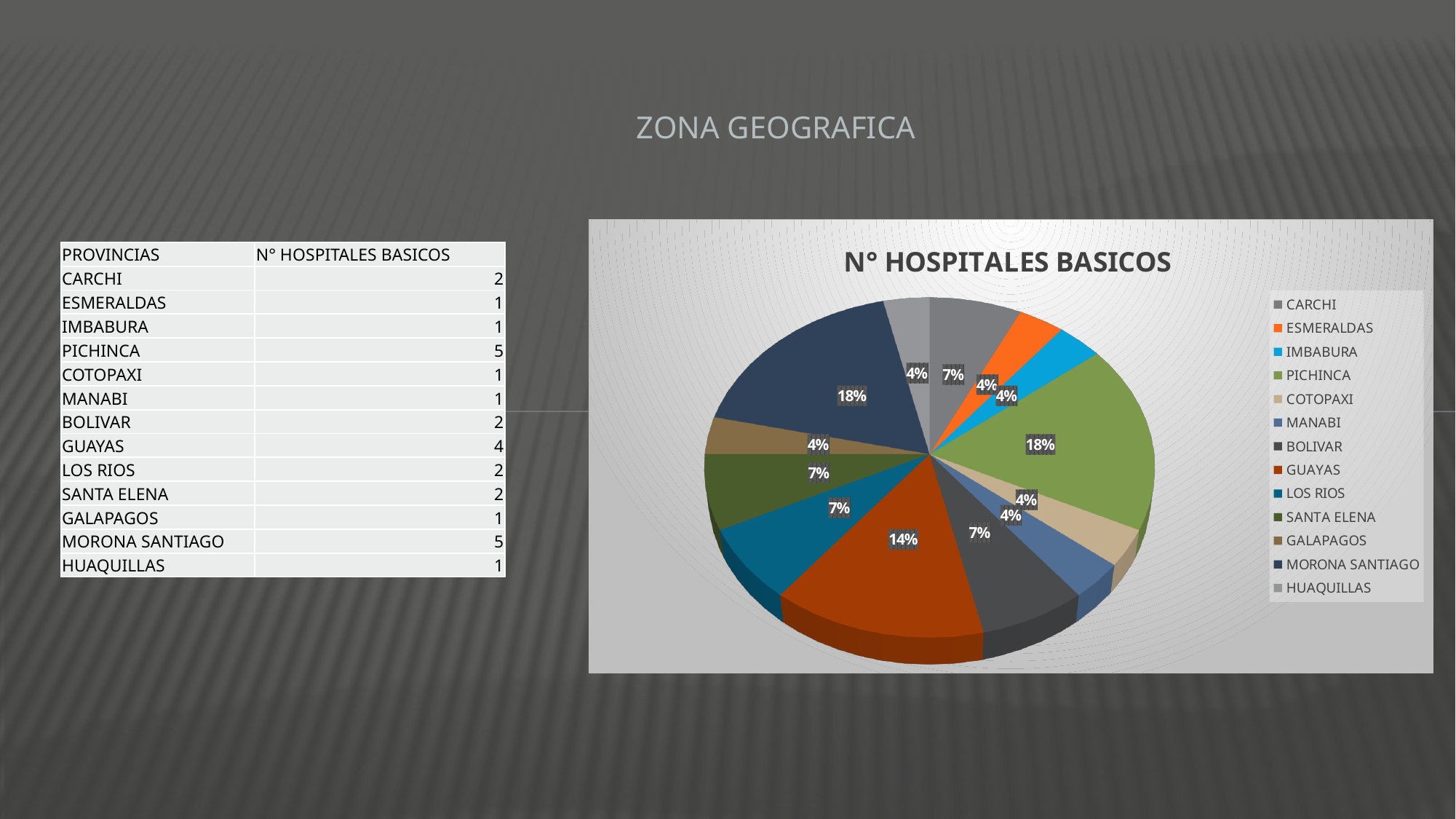
How many categories (provinces) does the pie chart show? 13 Which two provinces share the largest slice of the pie at 18%? PICHINCA and MORONA SANTIAGO What percentage is shown for ESMERALDAS in the pie chart? 4% What kind of chart is shown on the slide? pie chart Which slice is larger, PICHINCA or LOS RIOS? PICHINCA What is the difference in percentage points between the PICHINCA slice and the GUAYAS slice? 4 What share of the pie does GUAYAS represent? 14% What share of the pie does PICHINCA represent? 18% What percentage is shown for CARCHI in the pie chart? 7% What is the title of the chart? N° HOSPITALES BASICOS What share of the pie does MORONA SANTIAGO represent? 18% Which slice is larger, GUAYAS or BOLIVAR? GUAYAS